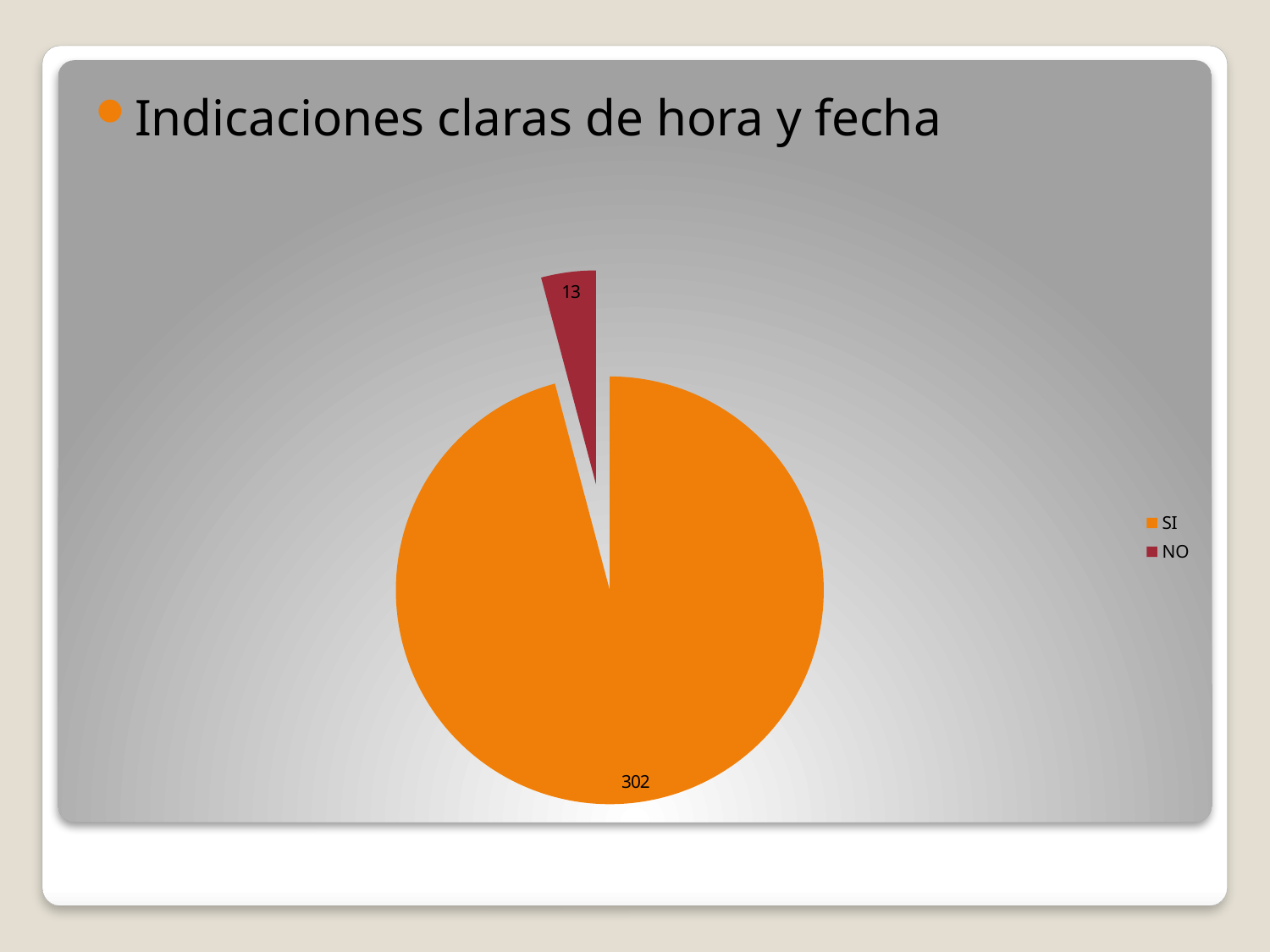
What is the value of the NO slice? 13 How many entries does the legend list? 2 What percentage of the total, rounded to one decimal place, does the SI slice represent? 95.9% Which category has the smallest slice? NO What kind of chart is shown on the slide? pie chart What is the value of the SI slice? 302 What is the difference between the SI and NO values? 289 Which is larger, the value for SI or the value for NO? SI How many slices does the pie chart have? 2 What colour is the NO slice? dark red What is the total of all slices in the pie chart? 315 Which category has the largest slice? SI